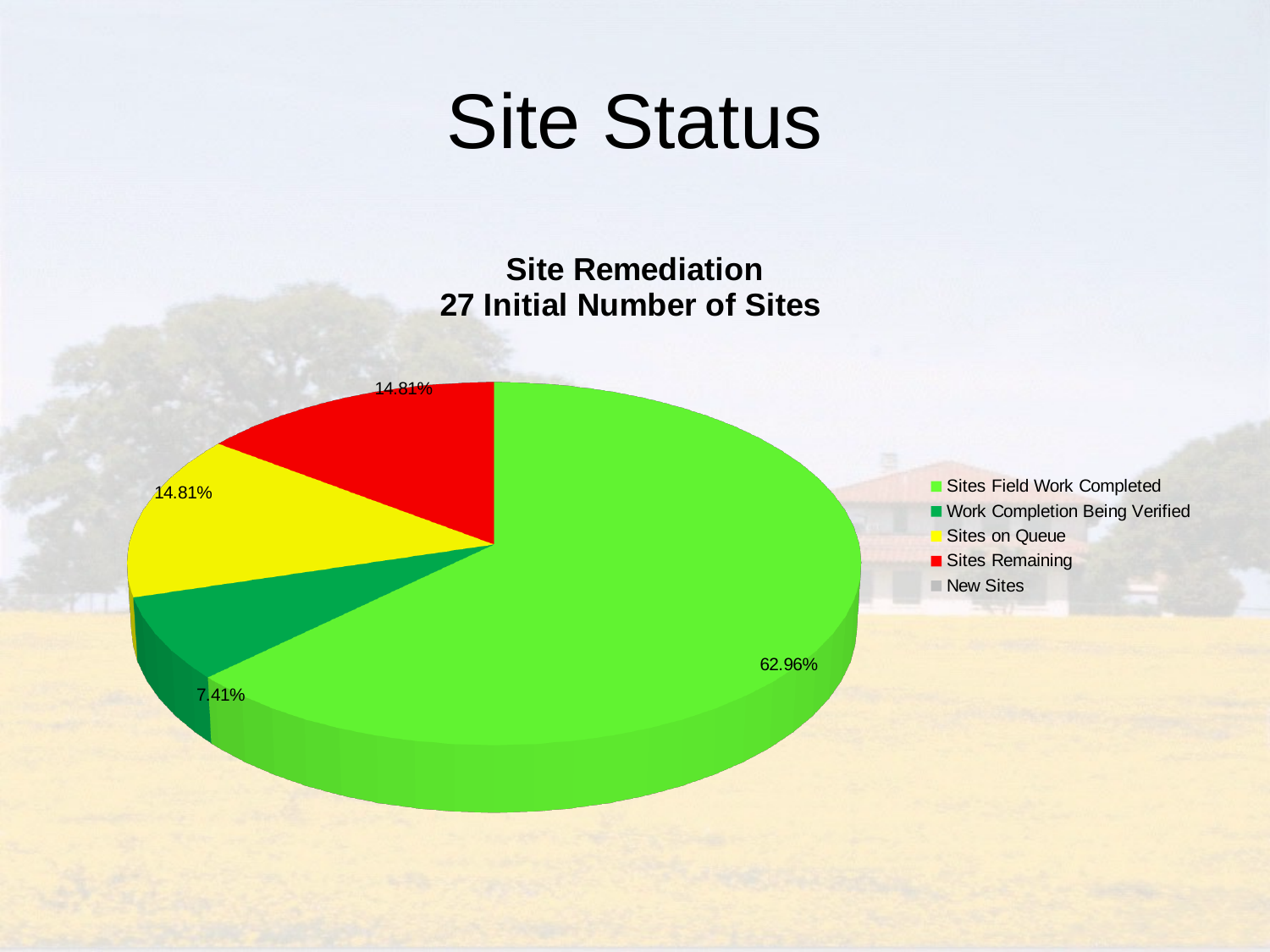
Which is larger, the slice for Sites Field Work Completed or the slice for Sites Remaining? Sites Field Work Completed Which of the labeled slices is the smallest? Work Completion Being Verified What is the difference in percentage points between Sites Field Work Completed and Sites Remaining? 48.15% What percentage is shown for Work Completion Being Verified? 7.41% What percentage of the pie is labeled for Sites Field Work Completed? 62.96% What is the difference in percentage points between Sites on Queue and Work Completion Being Verified? 7.40% What percentage is shown for Sites Remaining? 14.81% What percentage is shown for Sites on Queue? 14.81% How many categories does the legend list? 5 What kind of chart is shown on the slide? Pie chart Which category has the largest slice of the pie? Sites Field Work Completed What is the title of the chart? Site Remediation 27 Initial Number of Sites